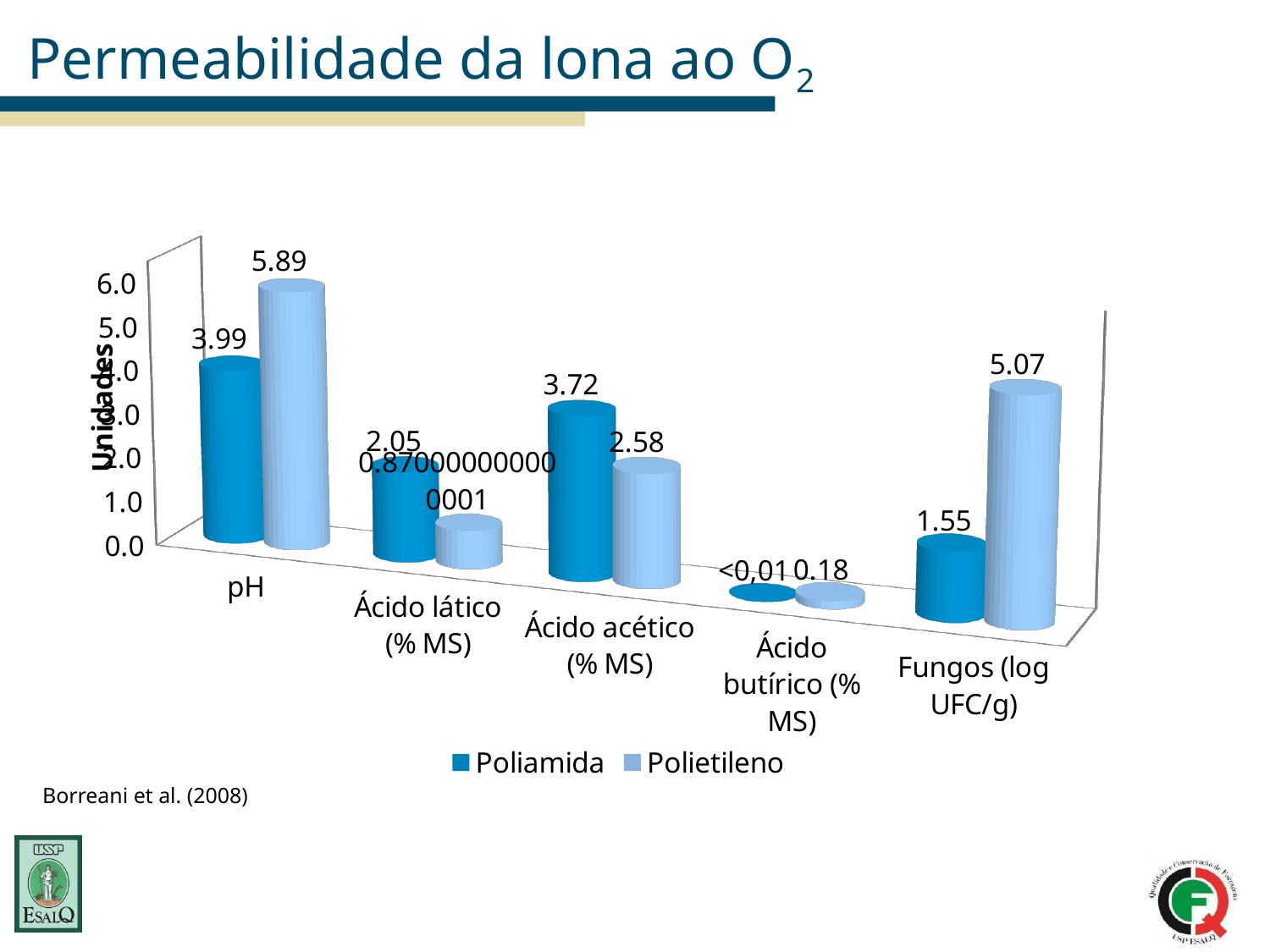
What is the Fungos (log UFC/g) value for Polietileno? 5.07 How many series does the legend list? 2 What is the difference between the Poliamida and Polietileno values for Ácido acético (% MS)? 1.14 What is the pH value for Polietileno? 5.89 What is the difference between the Polietileno and Poliamida pH values? 1.9 What kind of chart is shown on the slide? Bar chart Which series has the larger value for Ácido lático (% MS), Poliamida or Polietileno? Poliamida Which series has the larger value for Fungos (log UFC/g), Poliamida or Polietileno? Polietileno What is the Ácido butírico (% MS) value for Polietileno? 0.18 How many categories are shown on the x axis? 5 What is the pH value for Poliamida? 3.99 What is the Ácido acético (% MS) value for Poliamida? 3.72